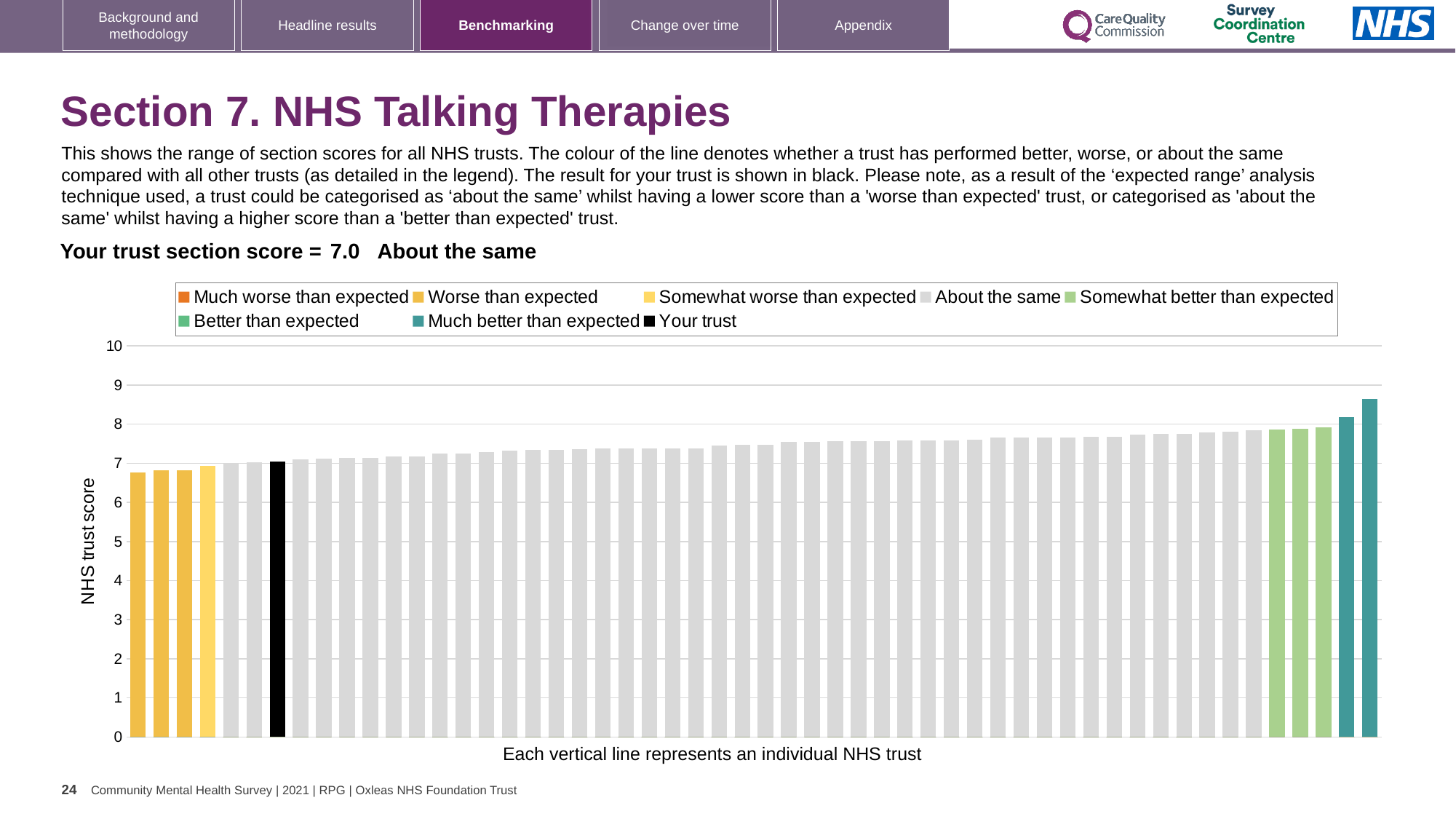
What colour is the bar representing your trust? black Is the value of the shortest bar greater or less than 7? less Is the value of the tallest bar greater or less than 9? less Do the bar values rise or fall from left to right along the x axis? rise Is the value of the tallest bar greater or less than 8? greater Which legend category does the trust with the highest score belong to? Much better than expected What is the section score for your trust shown on the slide? 7.0 What is the label on the vertical axis of the chart? NHS trust score How many bars are coloured as 'Much better than expected'? 2 How many entries does the chart legend list? 8 How is your trust's score categorised compared with other trusts? About the same What kind of chart is shown on the slide? bar chart